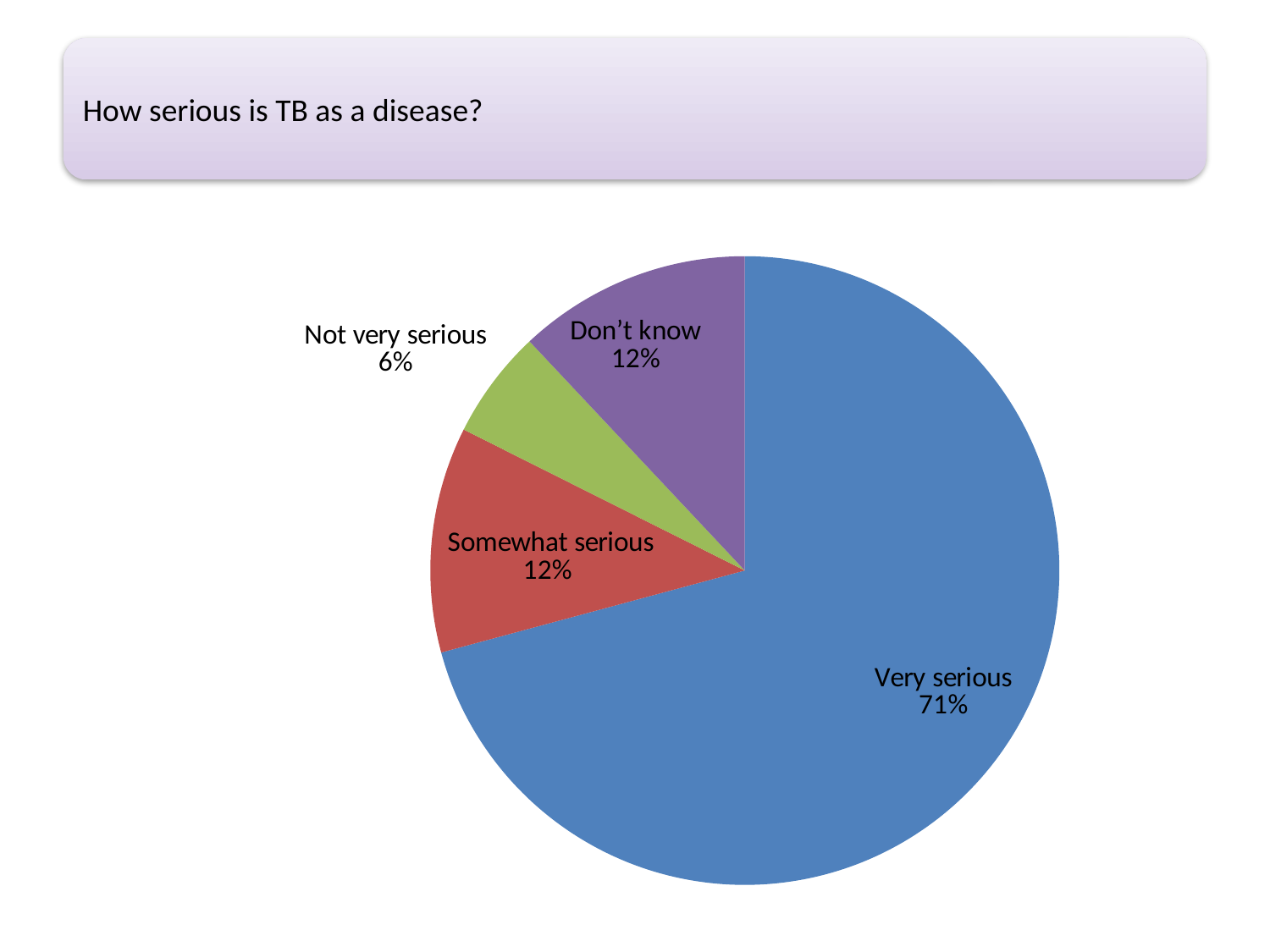
What share of the pie is 'Not very serious'? 6% What is the difference in percentage points between 'Very serious' and 'Somewhat serious'? 59 What is the difference in percentage points between 'Don't know' and 'Not very serious'? 6 What colour is the 'Very serious' slice? blue Which category has the smallest slice of the pie? Not very serious What share of the pie is 'Very serious'? 71% How many slices does the pie chart have? 4 What share of the pie is 'Don't know'? 12% What kind of chart is shown on the slide? pie chart Which is larger, the 'Very serious' slice or the 'Not very serious' slice? Very serious Which category has the largest slice of the pie? Very serious